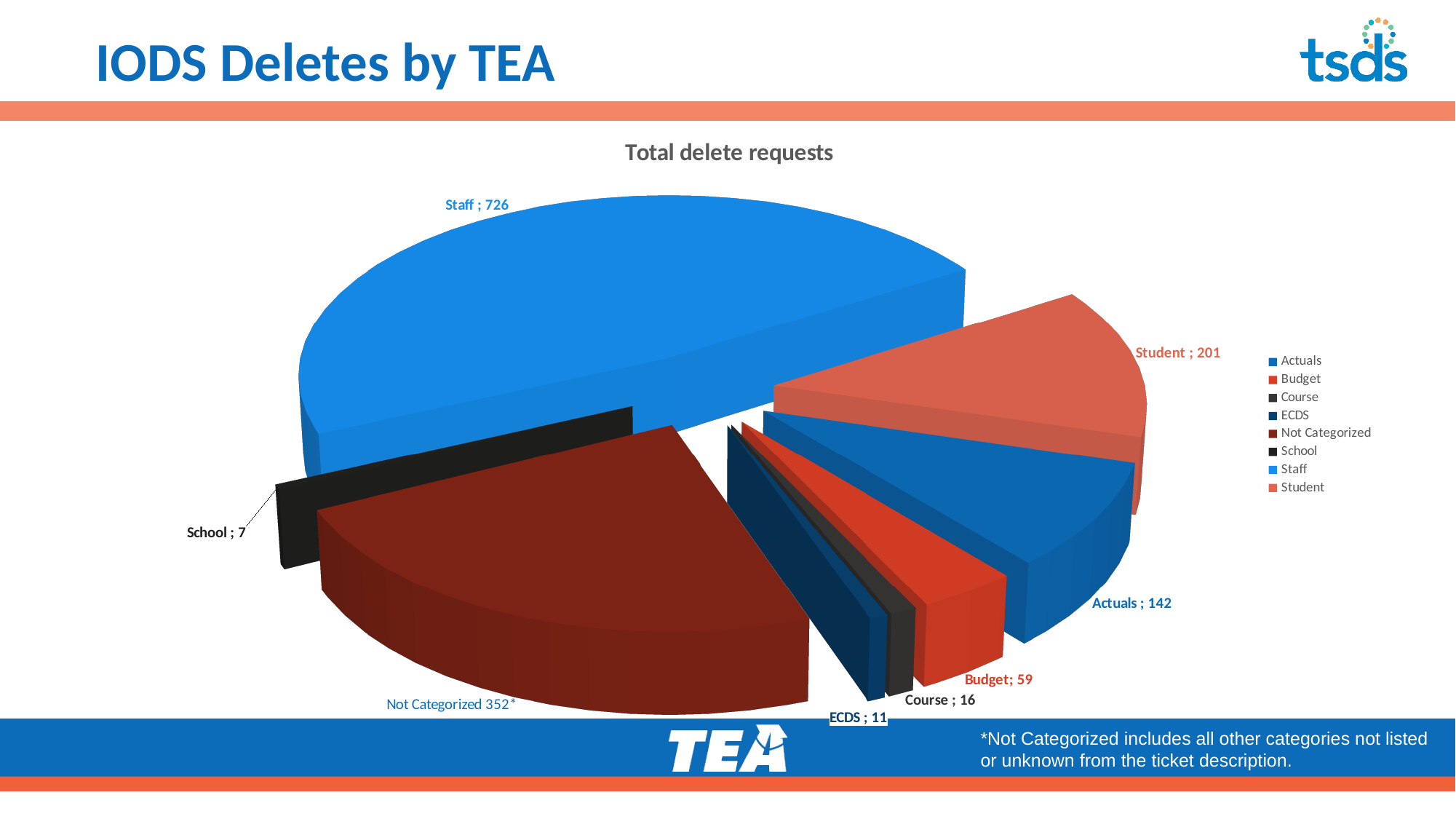
Which category has the smallest number of delete requests? School How many delete requests are shown for Budget? 59 How many delete requests are shown for Student? 201 How many categories does the legend list? 8 What is the total number of delete requests across all slices? 1514 What is the difference between the Staff and Not Categorized delete requests? 374 What kind of chart is shown on the slide? Pie chart Which has more delete requests, Actuals or Student? Student Which category has the largest number of delete requests? Staff How many delete requests are shown for Staff? 726 What is the title of the chart? Total delete requests